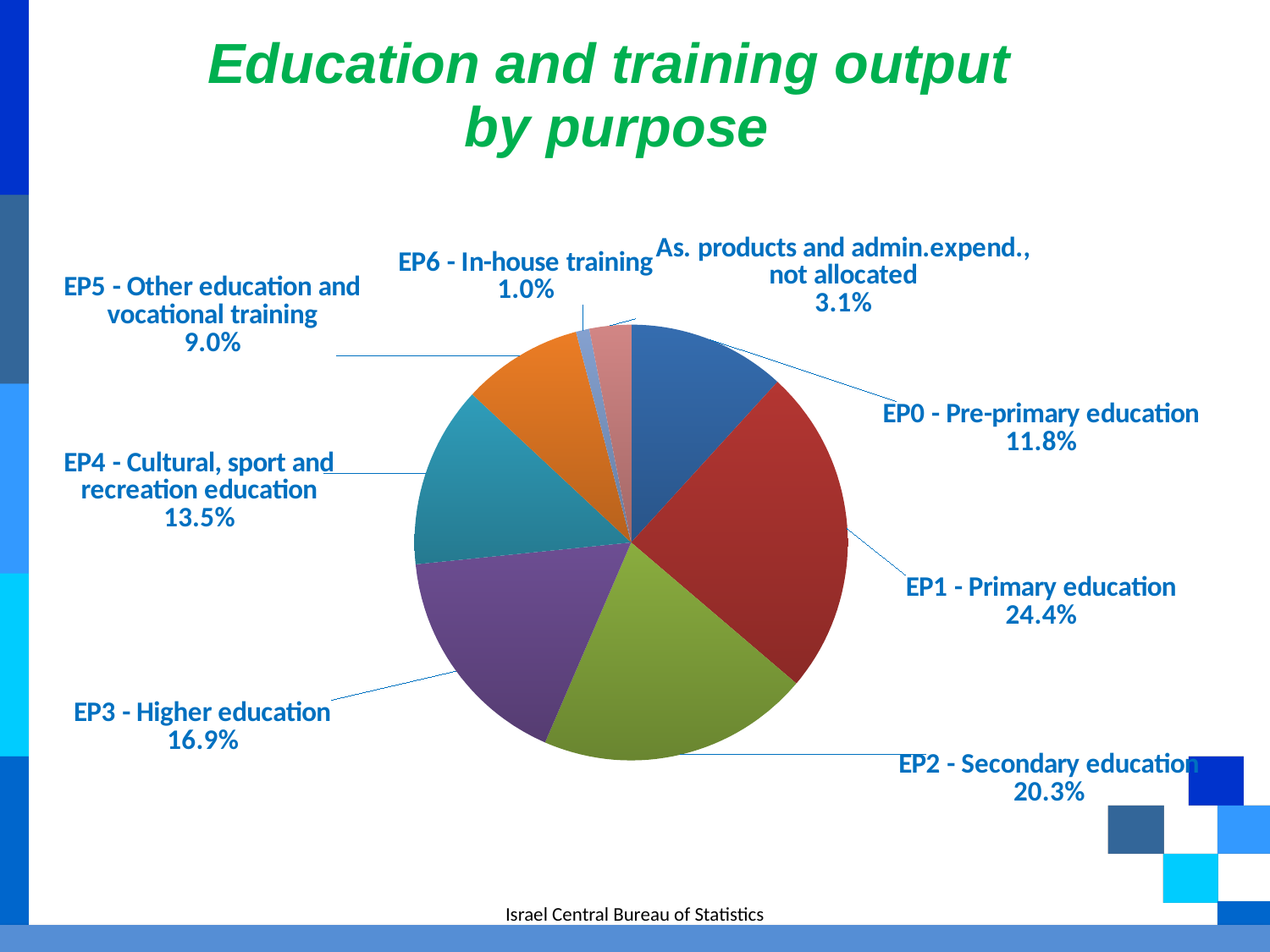
What is the title of the slide containing the pie chart? Education and training output by purpose Which purpose has the largest share of education and training output? EP1 - Primary education Which purpose has the smallest share of education and training output? EP6 - In-house training What share of education and training output is EP6 - In-house training? 1.0% What share is shown for 'As. products and admin.expend., not allocated'? 3.1% What share of education and training output is EP1 - Primary education? 24.4% Which has a larger share: EP5 - Other education and vocational training or EP0 - Pre-primary education? EP0 - Pre-primary education What share of education and training output is EP4 - Cultural, sport and recreation education? 13.5% What kind of chart is shown on the slide? pie chart What is the difference in percentage points between EP1 - Primary education and EP0 - Pre-primary education? 12.6 What is the difference in percentage points between EP2 - Secondary education and EP3 - Higher education? 3.4 How many slices does the pie chart have? 8